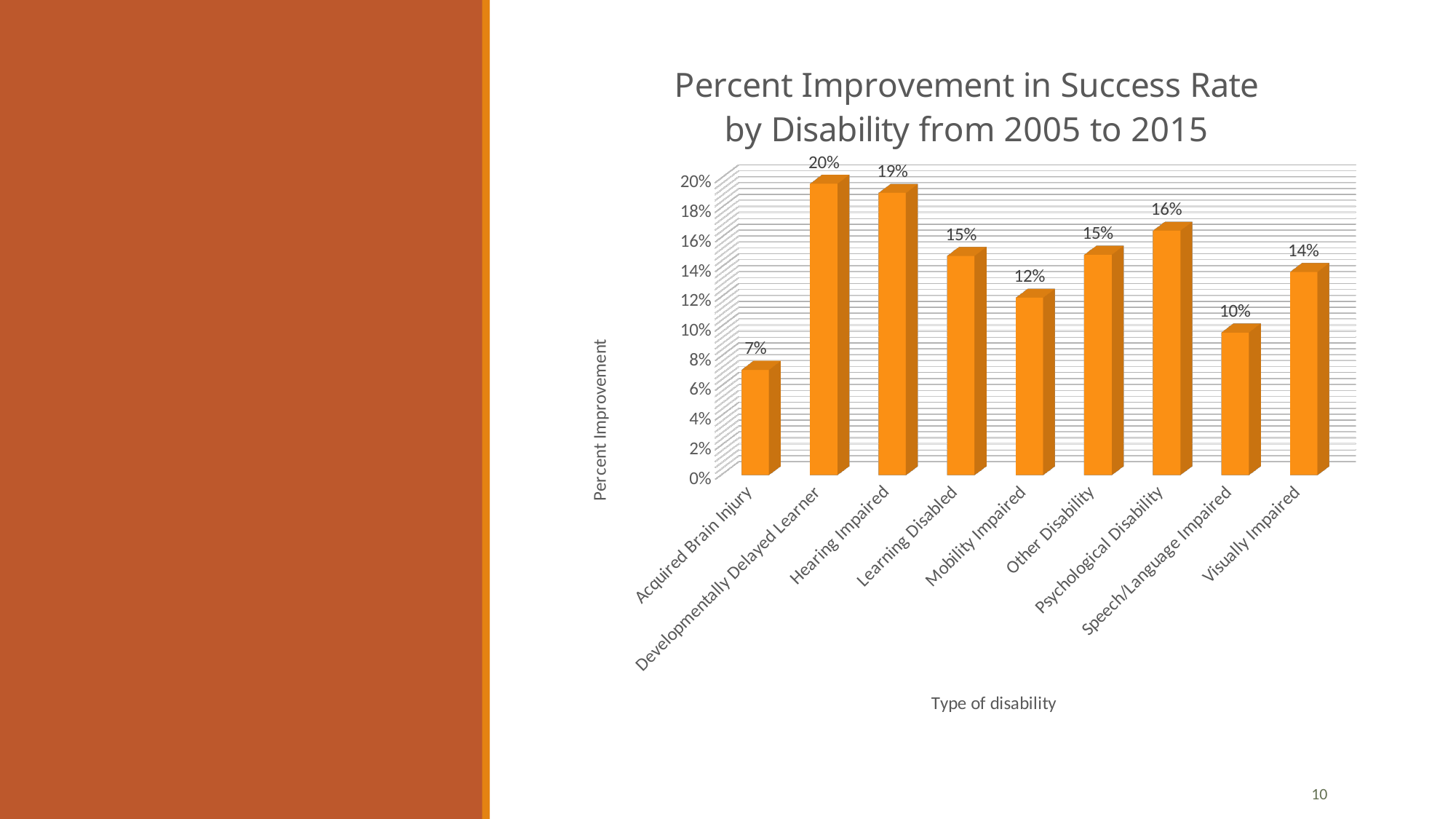
What is the percent improvement for Speech/Language Impaired? 10% What is the title of the chart? Percent Improvement in Success Rate by Disability from 2005 to 2015 Which type of disability has the highest percent improvement? Developmentally Delayed Learner What is the percent improvement for Acquired Brain Injury? 7% What is the percent improvement for Psychological Disability? 16% What is the percent improvement for Learning Disabled? 15% Which type of disability has the lowest percent improvement? Acquired Brain Injury What is the difference between the percent improvement for Hearing Impaired and Mobility Impaired? 7% How many types of disability are shown on the x axis? 9 What kind of chart is shown on the slide? Bar chart What is the label of the x axis? Type of disability Which has a larger percent improvement, Visually Impaired or Speech/Language Impaired? Visually Impaired